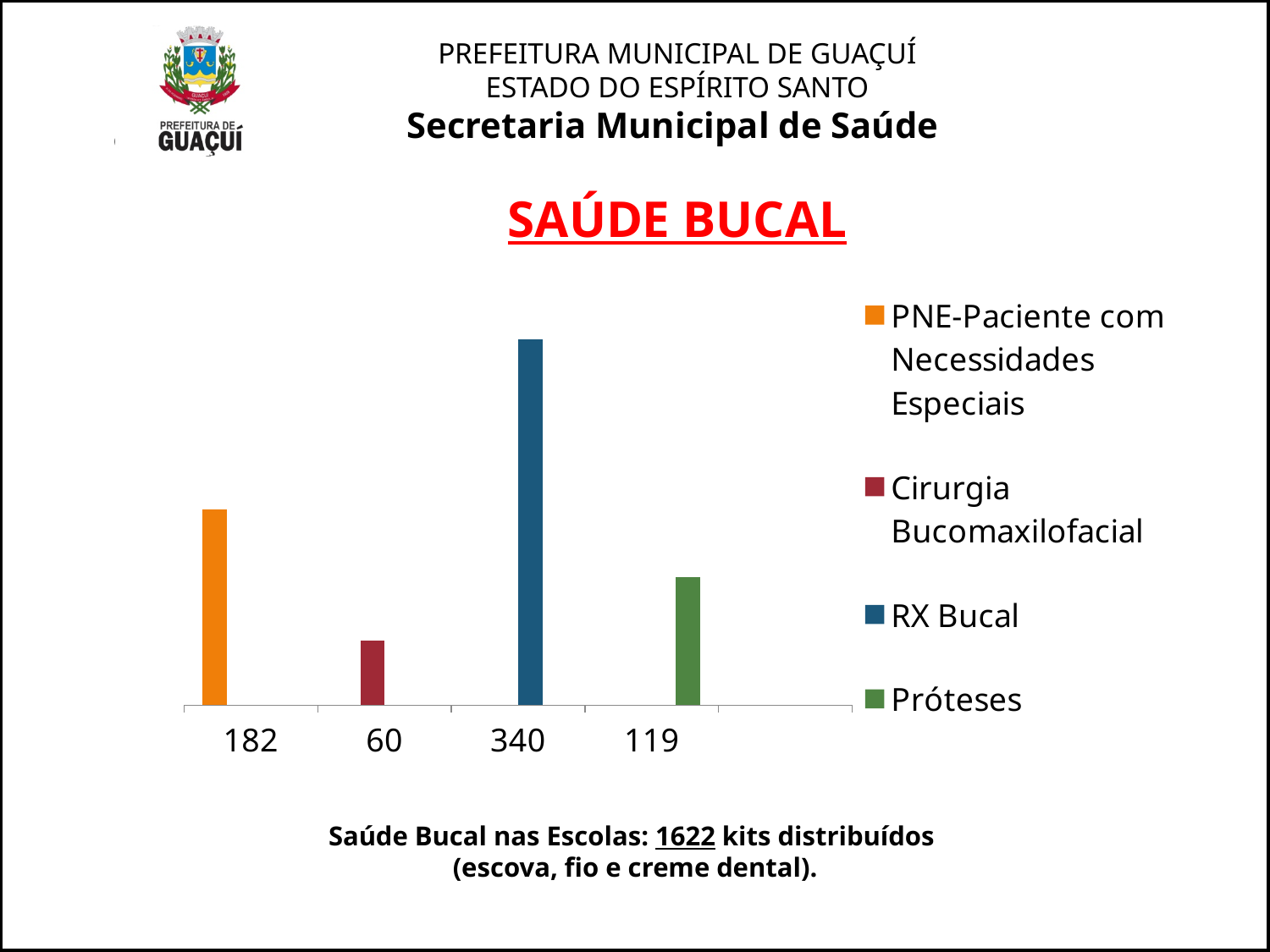
What value is shown for Cirurgia Bucomaxilofacial? 60 How many series does the legend list? 4 Which series has the lowest value? Cirurgia Bucomaxilofacial What kind of chart is shown on the slide? Bar chart What value is shown for RX Bucal? 340 Which is larger, the value for PNE-Paciente com Necessidades Especiais or the value for Próteses? PNE-Paciente com Necessidades Especiais What is the difference between the values for PNE-Paciente com Necessidades Especiais and Cirurgia Bucomaxilofacial? 122 What colour is the bar for RX Bucal? Blue What is the difference between the values for RX Bucal and Próteses? 221 What value is shown for Próteses? 119 What value is shown for PNE-Paciente com Necessidades Especiais? 182 Which series has the highest value? RX Bucal